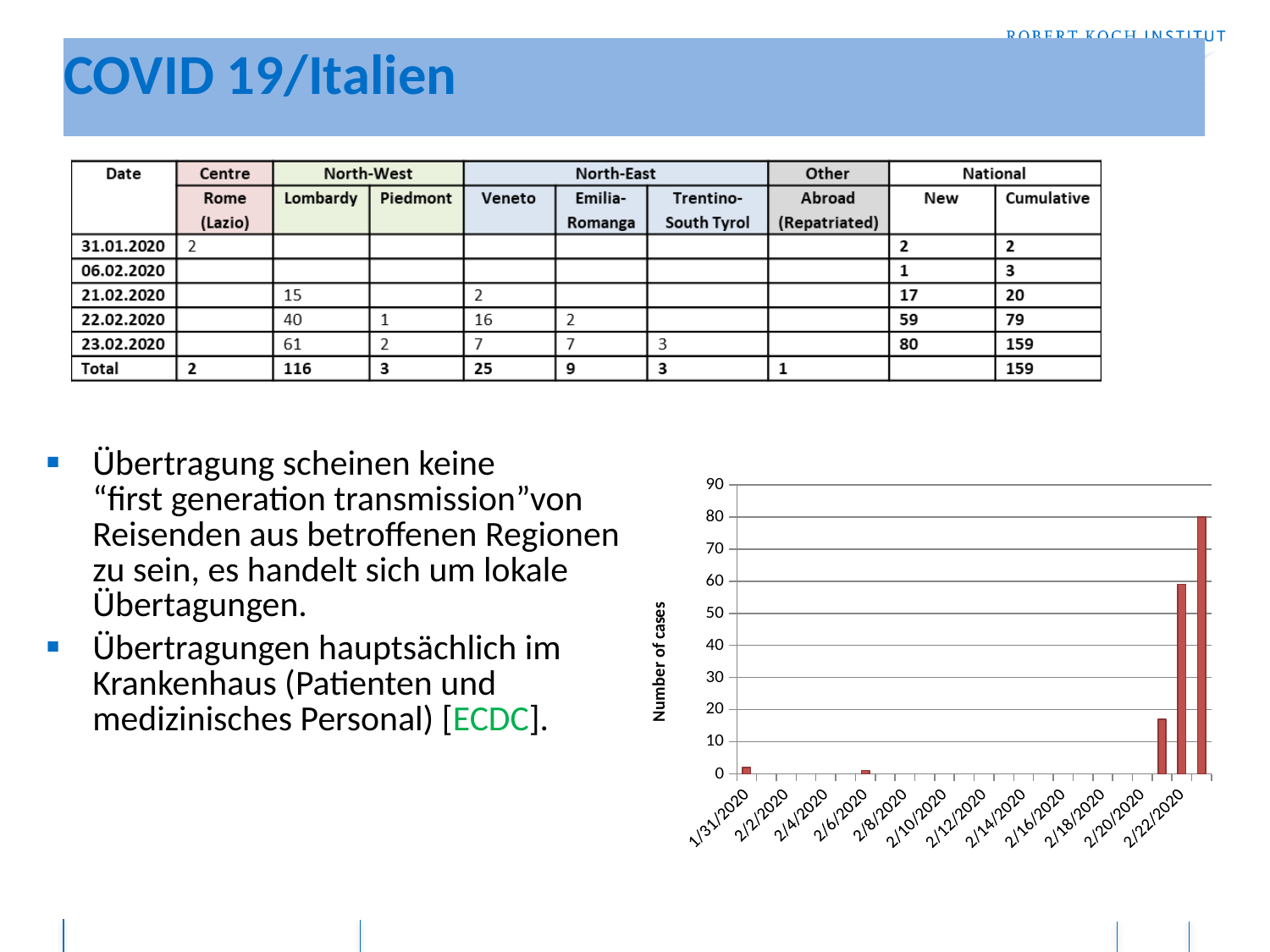
How many visible bars are plotted in the chart? 5 Is the tallest bar located at the left end or the right end of the x axis? right end Is the value for 1/31/2020 greater or less than 10? less Do the bar values rise or fall toward the right end of the x axis? rise What is the first date label on the x axis? 1/31/2020 Is the value of the tallest bar in the chart greater or less than 70? greater What is the highest tick value shown on the y axis? 90 Is the value of the third-tallest bar in the chart greater or less than 30? less What is the label on the y axis of the chart? Number of cases What kind of chart is shown on the slide? bar chart